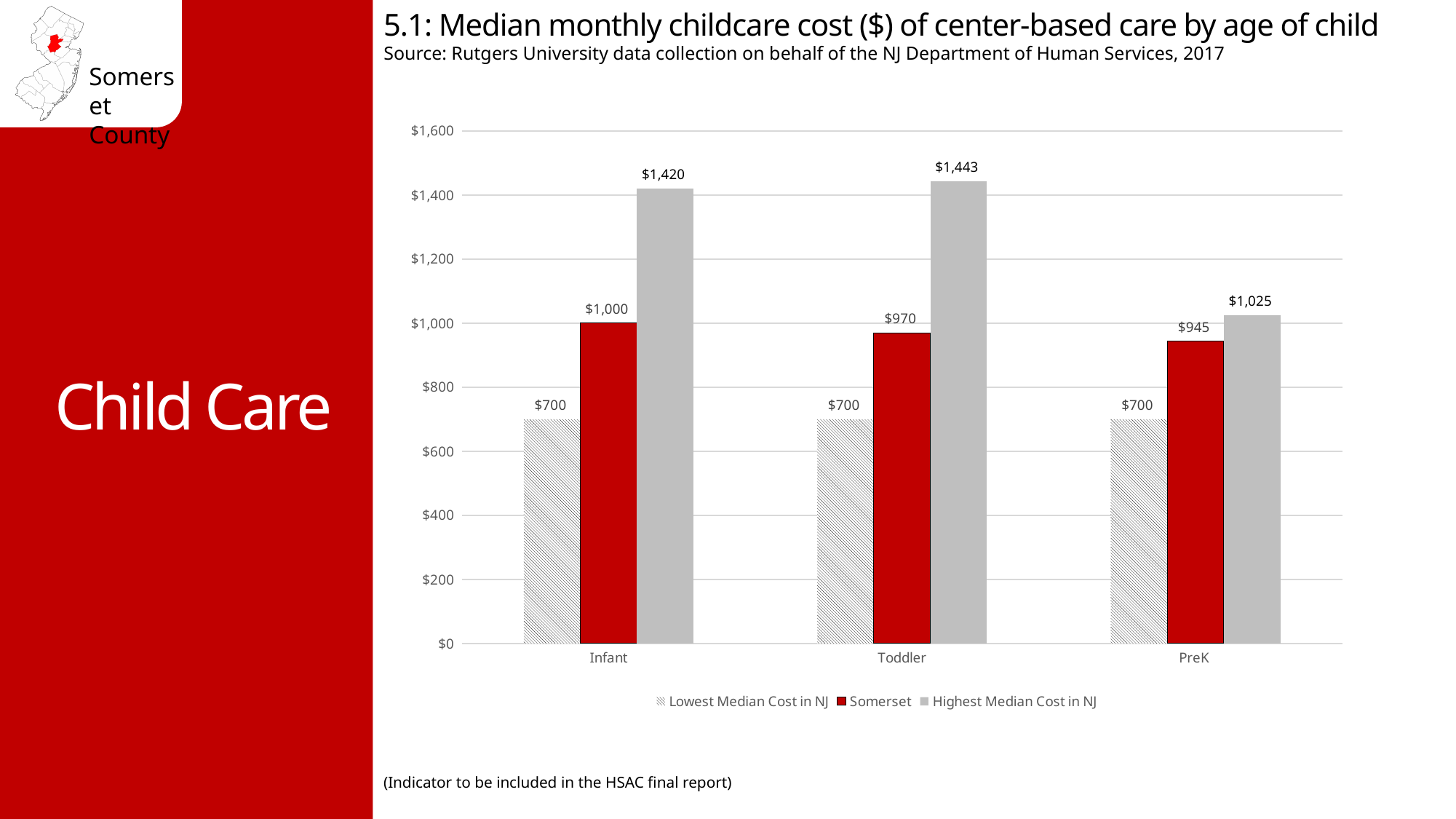
Which age group has the highest Somerset median monthly cost? Infant How many age groups are shown on the x axis? 3 What is the Somerset median monthly childcare cost for Infant care? $1,000 How many series does the legend list? 3 Which age group has the lowest Highest Median Cost in NJ? PreK Which is larger: the Somerset cost for Toddler care or the Somerset cost for PreK care? Toddler Does the Somerset median monthly cost rise or fall from Infant to PreK? Fall What is the Somerset median monthly cost for PreK care? $945 What is the Highest Median Cost in NJ for Toddler care? $1,443 What is the Lowest Median Cost in NJ for PreK care? $700 What is the difference between the Highest Median Cost in NJ and the Somerset cost for Infant care? $420 What kind of chart is shown on the slide? Bar chart